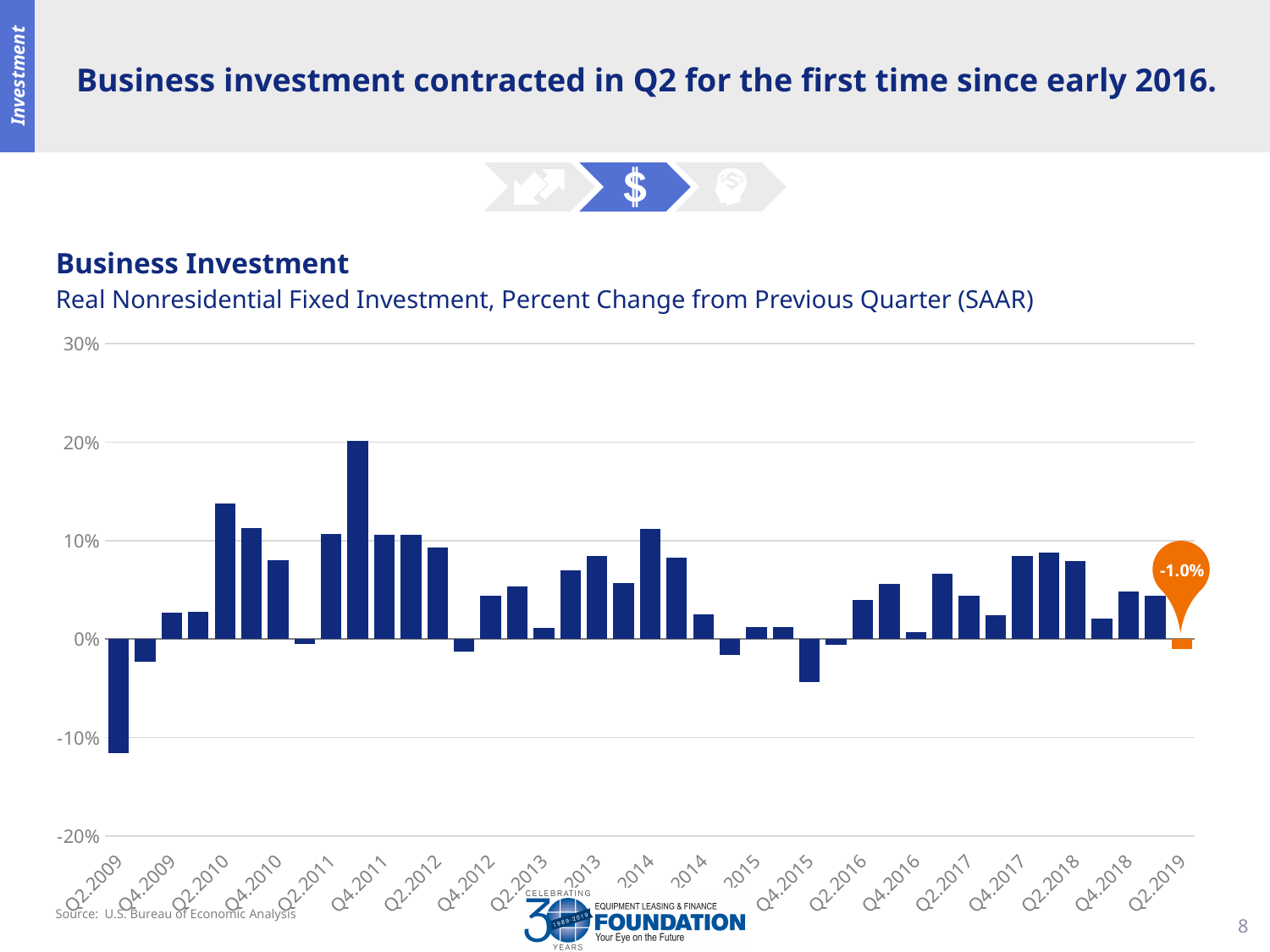
Which is lower, the value for Q2.2009 or the value for Q2.2019? Q2.2009 Does the value rise or fall from Q4.2018 to Q2.2019? fall Is the value for Q2.2010 greater or less than 10%? greater What is the source cited for the chart data? U.S. Bureau of Economic Analysis What kind of chart is shown on the slide? bar chart Is the value for Q2.2009 greater or less than -10%? less Which quarter has the lowest value in the chart? Q2.2009 Which quarter has the highest value in the chart? Q3.2011 What is the value shown for Q2.2019? -1.0% Which is larger, the value for Q4.2011 or the value for Q2.2010? Q2.2010 Is the value for Q4.2015 greater or less than 0%? less